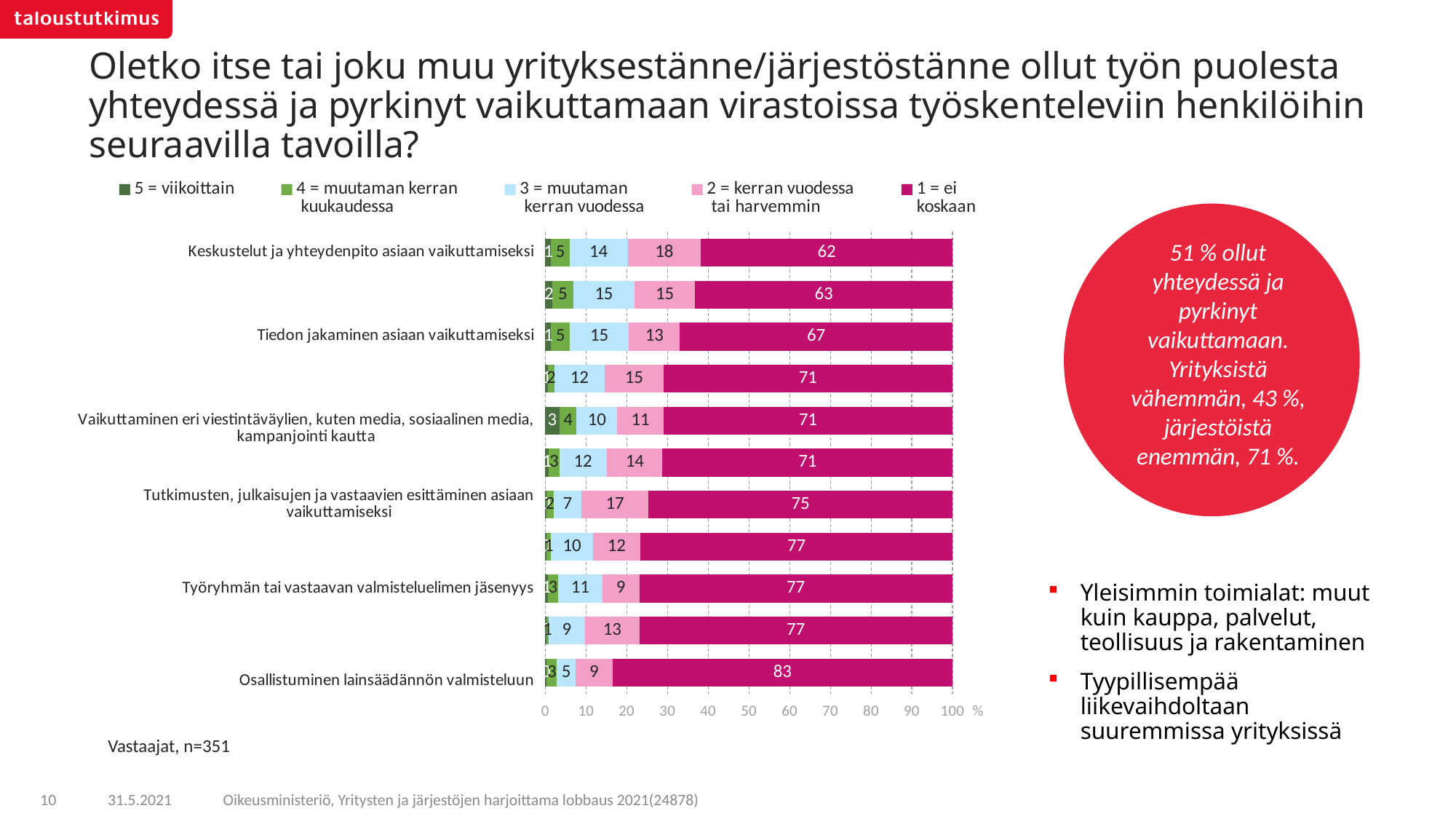
What is the value of '2 = kerran vuodessa tai harvemmin' for 'Keskustelut ja yhteydenpito asiaan vaikuttamiseksi'? 18 What is the value of '1 = ei koskaan' for 'Osallistuminen lainsäädännön valmisteluun'? 83 What is the value of '1 = ei koskaan' for 'Keskustelut ja yhteydenpito asiaan vaikuttamiseksi'? 62 Which has a larger '1 = ei koskaan' value: 'Tiedon jakaminen asiaan vaikuttamiseksi' or 'Tutkimusten, julkaisujen ja vastaavien esittäminen asiaan vaikuttamiseksi'? Tutkimusten, julkaisujen ja vastaavien esittäminen asiaan vaikuttamiseksi How many series does the chart legend list? 5 What is the value of '3 = muutaman kerran vuodessa' for 'Tiedon jakaminen asiaan vaikuttamiseksi'? 15 How many bars are plotted in the chart? 11 Which labelled category has the lowest value for '1 = ei koskaan'? Keskustelut ja yhteydenpito asiaan vaikuttamiseksi What is the difference in the '1 = ei koskaan' value between 'Osallistuminen lainsäädännön valmisteluun' and 'Keskustelut ja yhteydenpito asiaan vaikuttamiseksi'? 21 What is the number of respondents (n) stated below the chart? n=351 What kind of chart is shown on the slide? Stacked bar chart Which labelled category has the highest value for '1 = ei koskaan'? Osallistuminen lainsäädännön valmisteluun